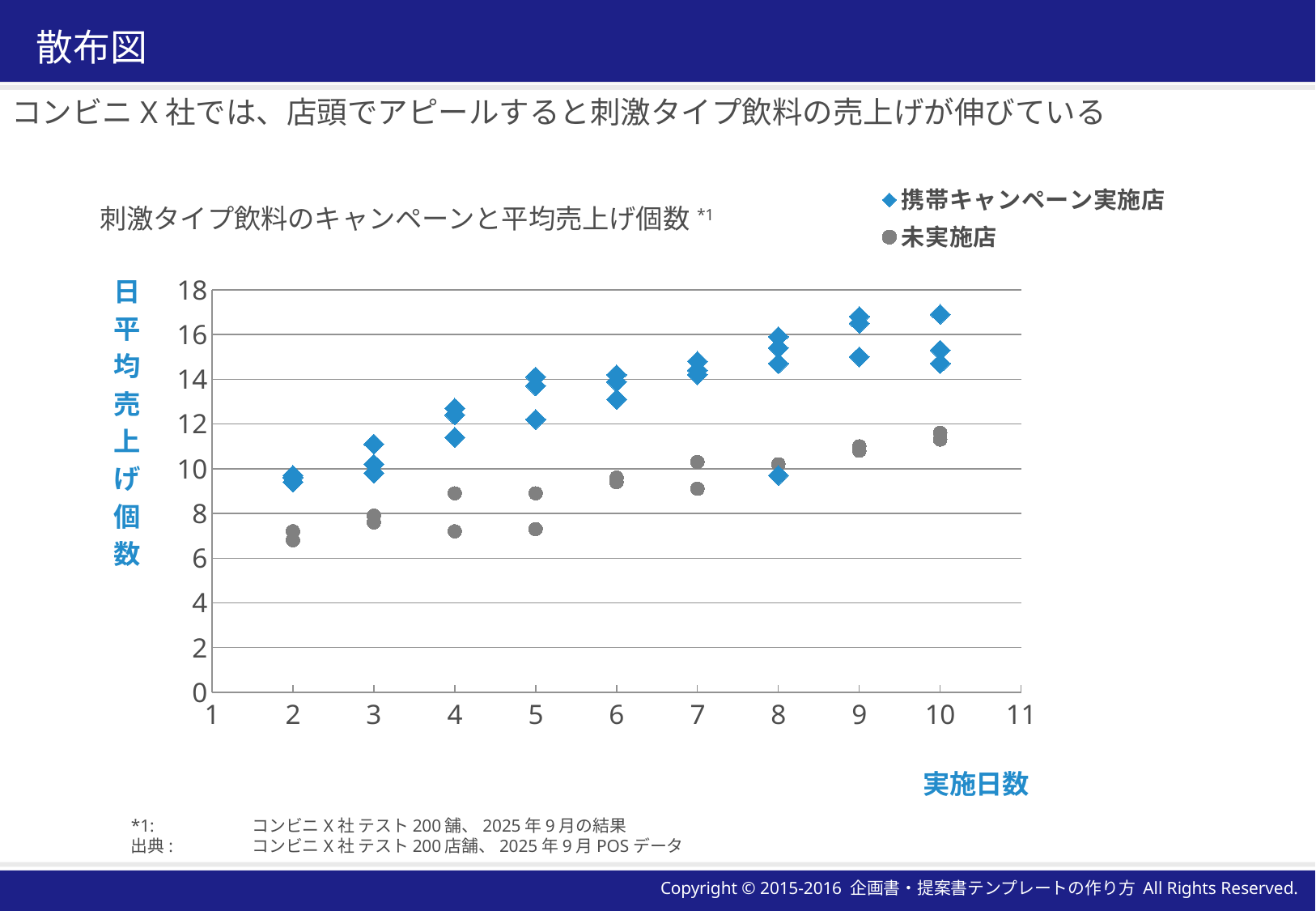
Do the values for 携帯キャンペーン実施店 rise or fall as 実施日数 increases? rise Are the 携帯キャンペーン実施店 values at 実施日数 = 4 greater or less than 10? greater Is the highest 携帯キャンペーン実施店 value at 実施日数 = 10 greater or less than 16? greater Do the values for 未実施店 rise or fall as 実施日数 increases? rise What kind of chart is shown on the slide? scatter chart Are the 未実施店 values at 実施日数 = 2 greater or less than 8? less What are the two series named in the legend? 携帯キャンペーン実施店 and 未実施店 How many series does the legend list? 2 At 実施日数 = 6, which series has the higher values, 携帯キャンペーン実施店 or 未実施店? 携帯キャンペーン実施店 What is the title of the chart? 刺激タイプ飲料のキャンペーンと平均売上げ個数 How many distinct 実施日数 values have data points plotted? 9